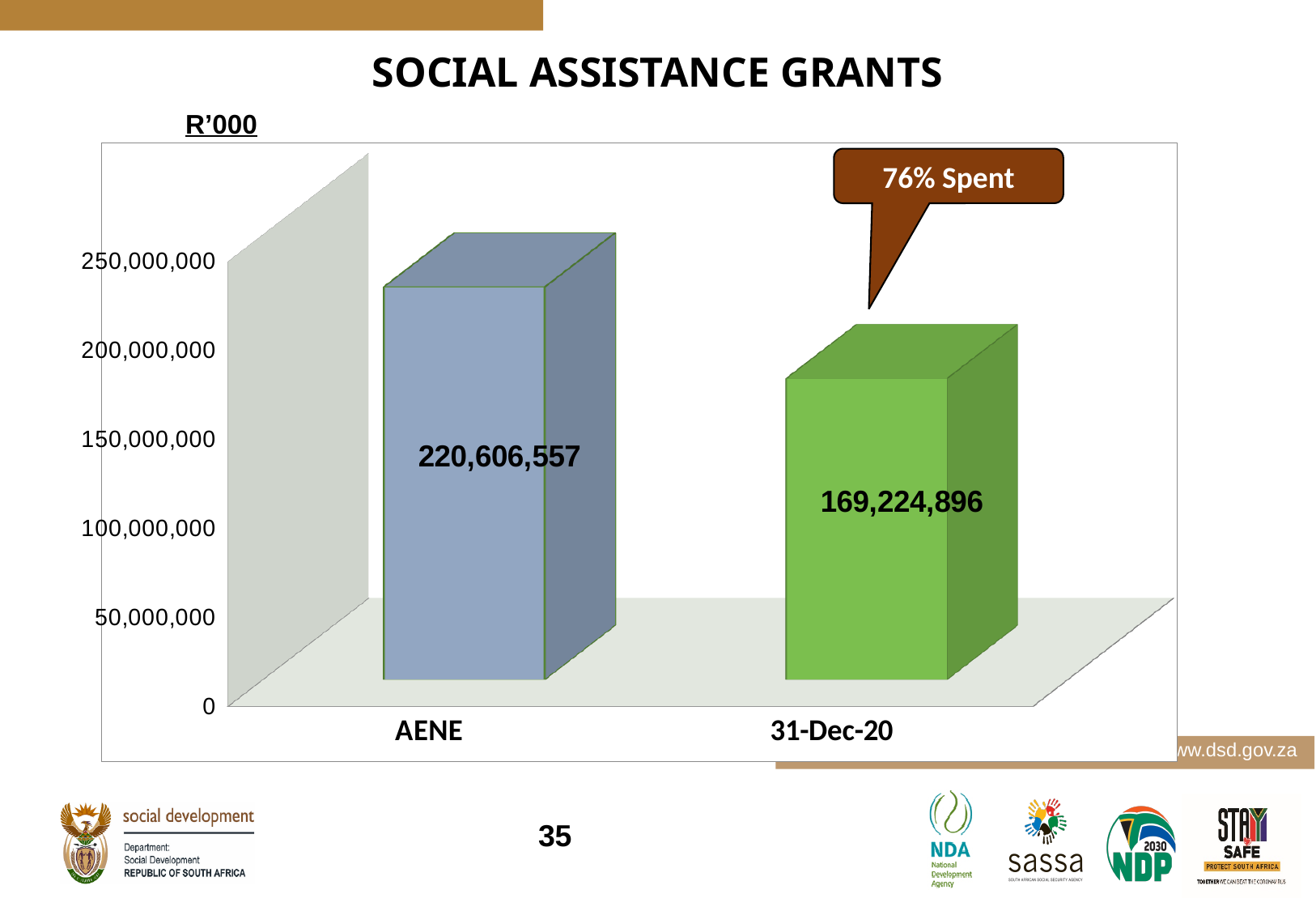
Which category has the highest value? AENE How many categories are shown on the x axis? 2 Is the value for AENE greater or less than 200,000,000? greater What is the title of the chart? SOCIAL ASSISTANCE GRANTS What is the difference between the AENE value and the 31-Dec-20 value? 51,381,661 Which category has the lowest value? 31-Dec-20 What is the value for 31-Dec-20? 169,224,896 What percentage spent does the callout on the chart show? 76% Spent What kind of chart is shown on the slide? bar chart Is the value for 31-Dec-20 greater or less than 200,000,000? less What is the value for AENE? 220,606,557 Which is larger, the value for AENE or the value for 31-Dec-20? AENE